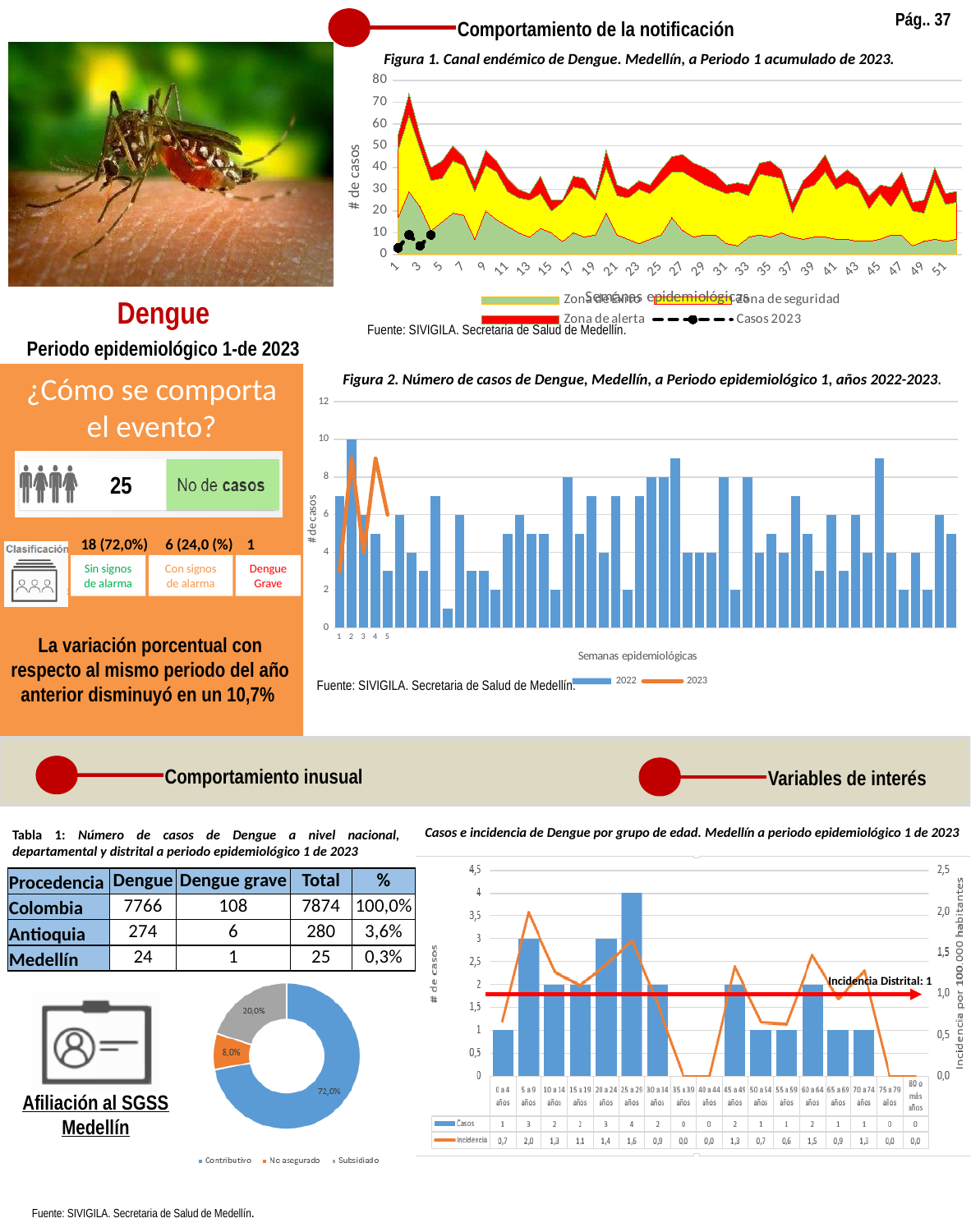
In Figura 1 (Canal endémico de Dengue), how many entries does the legend list? 4 In the donut chart 'Afiliación al SGSS Medellín', how many categories are shown? 3 In the chart 'Casos e incidencia de Dengue por grupo de edad', which is larger: the incidencia for 60 a 64 años or for 30 a 34 años? 60 a 64 años In the chart 'Casos e incidencia de Dengue por grupo de edad', what is the difference in casos between the 25 a 29 años group and the 0 a 4 años group? 3 In the chart 'Casos e incidencia de Dengue por grupo de edad', what is the incidencia for the 5 a 9 años group? 2,0 In the chart 'Casos e incidencia de Dengue por grupo de edad', which age group has the highest number of casos? 25 a 29 años In the chart 'Casos e incidencia de Dengue por grupo de edad', how many casos are reported for the 25 a 29 años group? 4 In Figura 2 (Número de casos de Dengue, Medellín, 2022-2023), what kind of chart is used for the 2022 series? Bar chart In Figura 2 (Número de casos de Dengue, Medellín, 2022-2023), is the 2022 value for week 2 greater or less than 8? greater In the donut chart 'Afiliación al SGSS Medellín', which category has the smallest share? No asegurado In the chart 'Casos e incidencia de Dengue por grupo de edad', how many series does the legend list? 2 In the donut chart 'Afiliación al SGSS Medellín', what share does Contributivo have? 72,0%